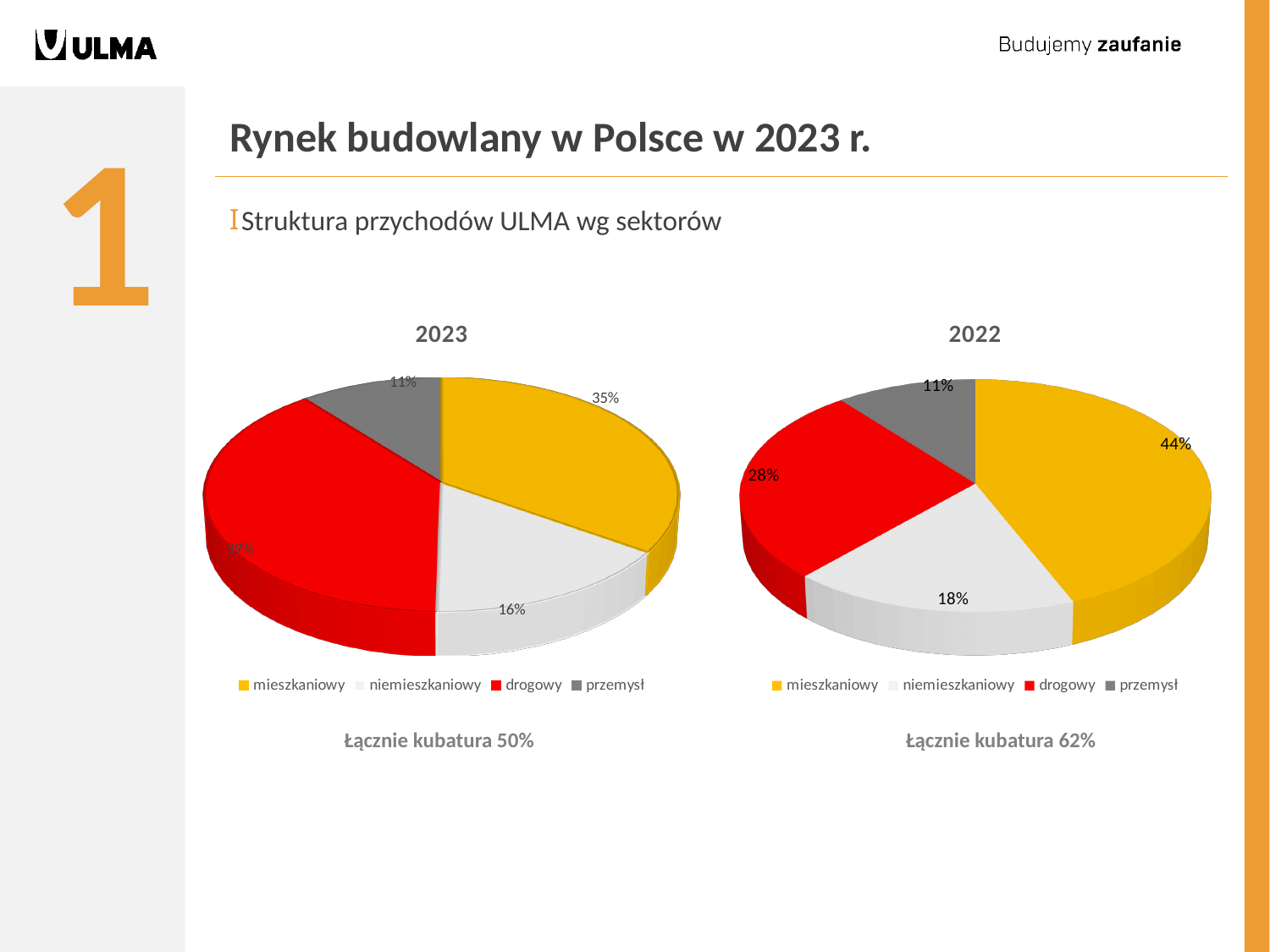
In the 2023 pie chart, what share does niemieszkaniowy have? 16% In the 2023 pie chart, what share does mieszkaniowy have? 35% In the 2022 pie chart, what is the difference between the mieszkaniowy and niemieszkaniowy shares? 26% In the 2022 pie chart, what share does mieszkaniowy have? 44% Which is larger: the mieszkaniowy share in 2023 or in 2022? 2022 In the 2022 pie chart, what share does drogowy have? 28% In the 2022 pie chart, which sector has the largest share? mieszkaniowy What type of chart is used for the 2022 data? Pie chart In the 2023 pie chart, which sector has the smallest share? przemysł In the 2022 pie chart, which sector has the smallest share? przemysł How many sectors does the legend of the 2023 pie chart list? 4 In the 2022 pie chart, what share does przemysł have? 11%